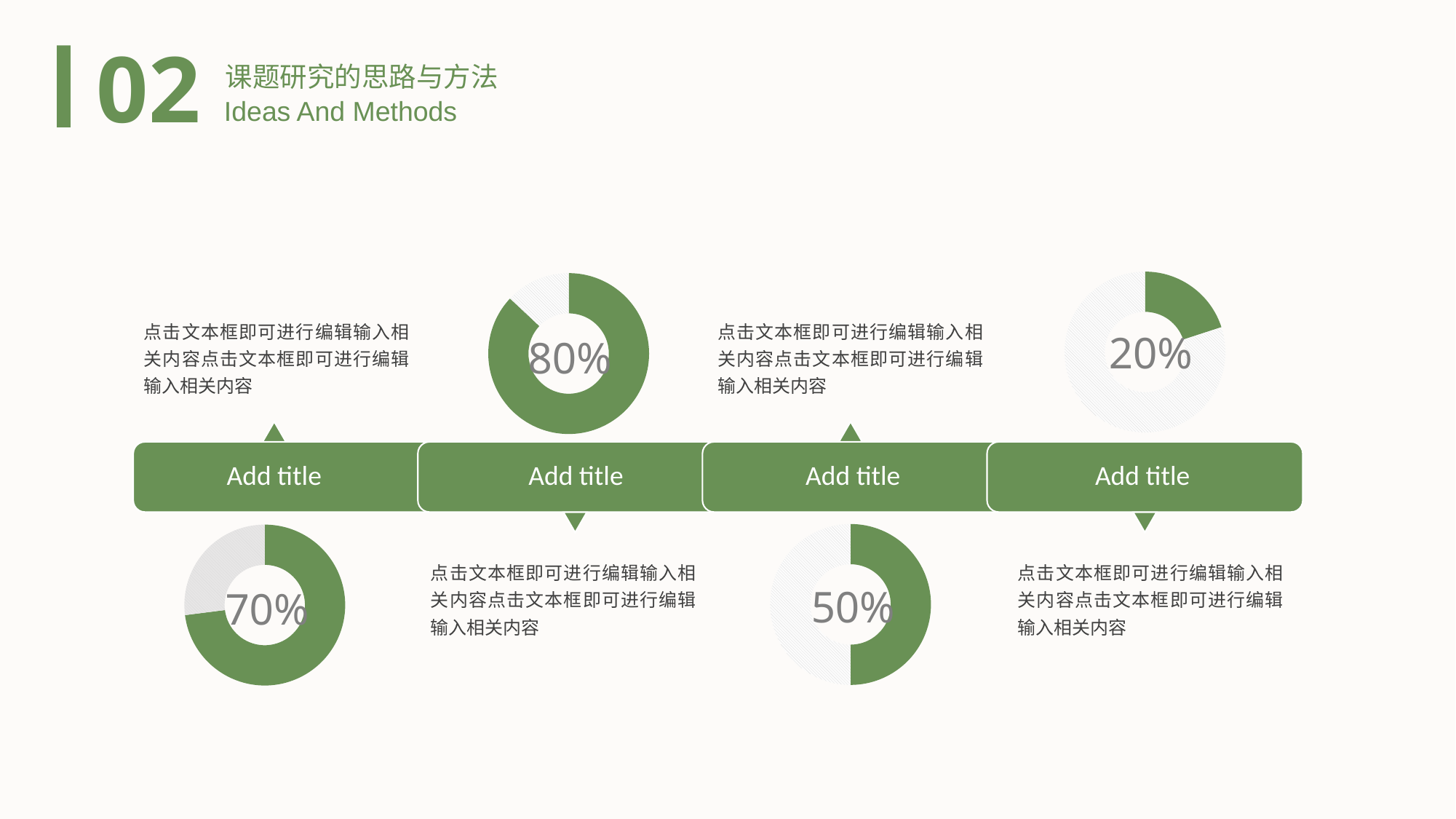
What percentage is shown in the donut chart at the top right of the slide? 20% What percentage is shown in the donut chart at the bottom centre-right of the slide (below the third 'Add title' box)? 50% How many donut charts are shown on the slide? 4 What percentage is shown in the donut chart at the top centre-left of the slide (above the second 'Add title' box)? 80% Which of the four donut charts on the slide shows the lowest percentage? The top right chart (20%) Which of the four donut charts on the slide shows the highest percentage? The top centre-left chart (80%) Which is larger: the percentage in the bottom left donut chart or the percentage in the top right donut chart? The bottom left chart (70%) What percentage is shown in the donut chart at the bottom left of the slide? 70% What kind of chart is used to display the percentages on the slide? Donut chart What colour is the filled portion of each donut chart on the slide? Green What is the difference between the percentage in the bottom left donut chart and the percentage in the bottom centre-right donut chart? 20% What is the difference between the percentage in the top centre-left donut chart and the percentage in the top right donut chart? 60%